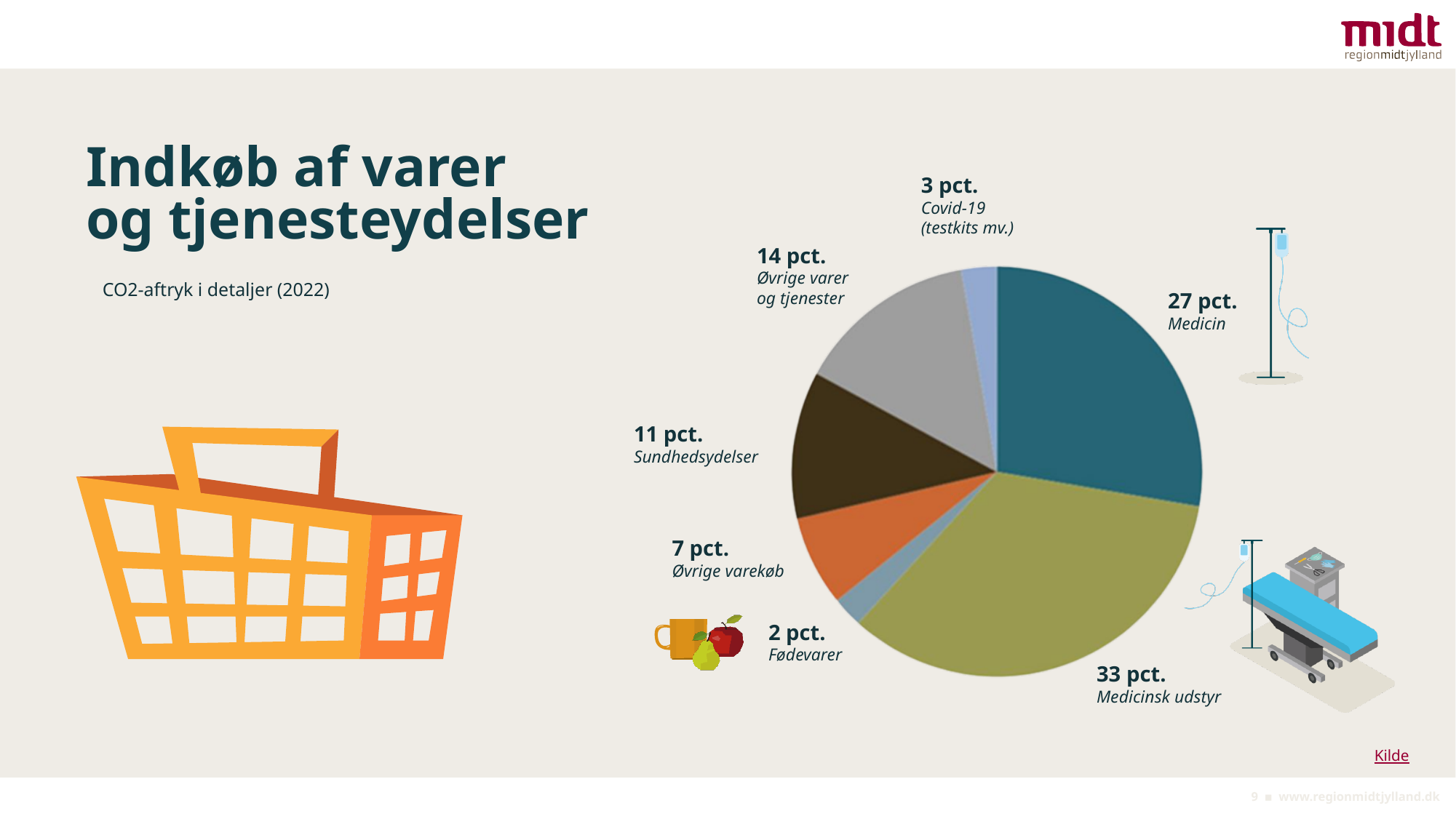
How many slices does the pie chart have? 7 What share of the pie chart is Medicinsk udstyr? 33 pct. Which is larger, Øvrige varekøb or Sundhedsydelser? Sundhedsydelser What share of the pie chart is Medicin? 27 pct. What type of chart is shown on the slide? Pie chart What is the subtitle shown under the slide title? CO2-aftryk i detaljer (2022) What share of the pie chart is Sundhedsydelser? 11 pct. What share of the pie chart is Covid-19 (testkits mv.)? 3 pct. Which category has the smallest slice of the pie chart? Fødevarer Which category has the largest slice of the pie chart? Medicinsk udstyr What is the difference in percentage points between Medicinsk udstyr and Medicin? 6 pct. What share of the pie chart is Øvrige varer og tjenester? 14 pct.